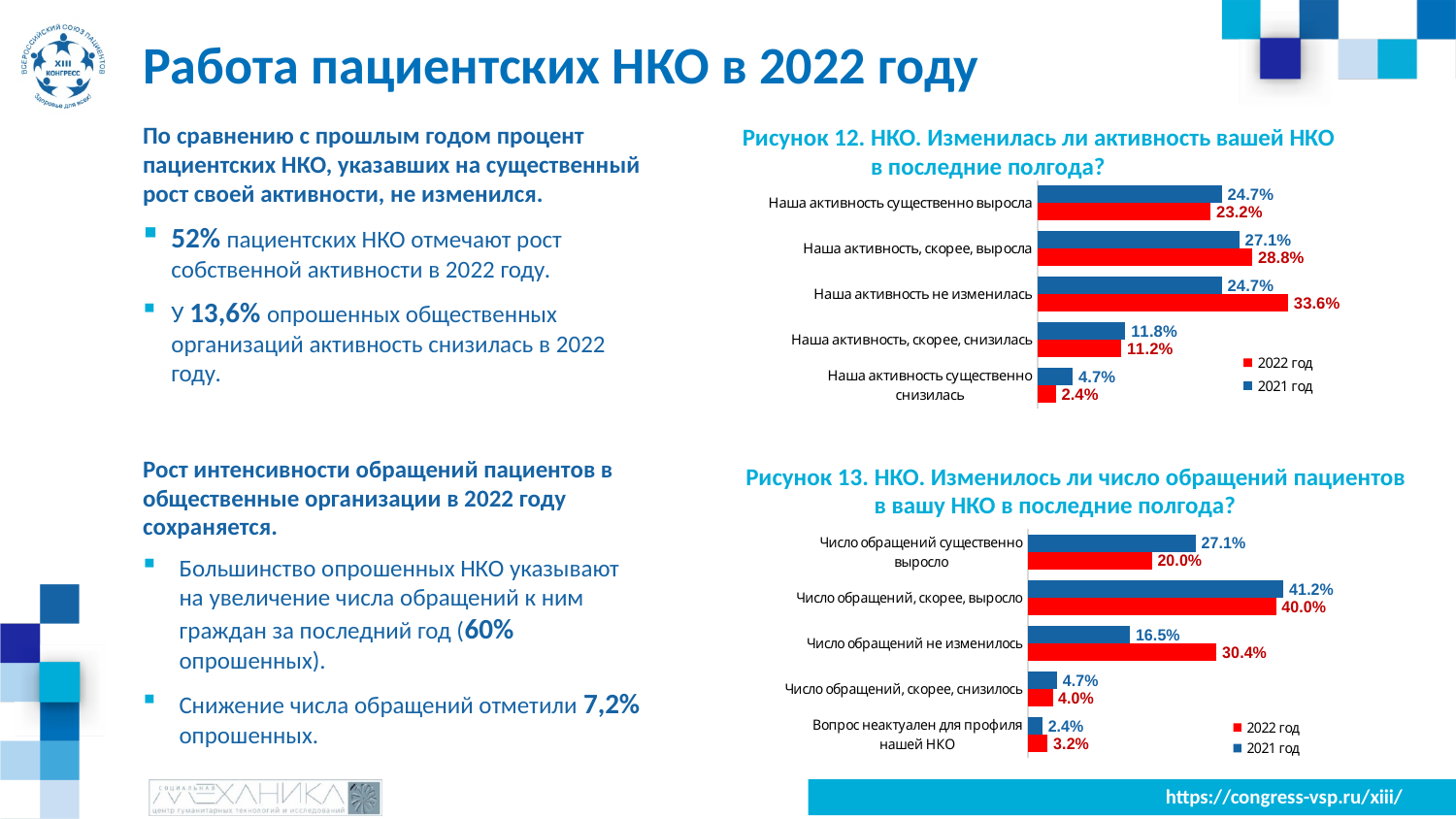
In the chart 'Рисунок 13', which category has the lowest value in the 2021 год series? Вопрос неактуален для профиля нашей НКО In the chart 'Рисунок 12', which is larger for 'Наша активность существенно выросла': the 2021 год value or the 2022 год value? 2021 год In the chart 'Рисунок 13', what is the value for 'Вопрос неактуален для профиля нашей НКО' in the 2022 год series? 3.2% In the chart 'Рисунок 12', which category has the highest value in the 2022 год series? Наша активность не изменилась What type of chart is 'Рисунок 13'? Bar chart In the chart 'Рисунок 13', what is the difference between the 2022 год and 2021 год values for 'Число обращений не изменилось'? 13.9% In the chart 'Рисунок 12', what is the value for 'Наша активность существенно снизилась' in the 2021 год series? 4.7% In the chart 'Рисунок 12. НКО. Изменилась ли активность вашей НКО в последние полгода?', what is the value for 'Наша активность не изменилась' in the 2022 год series? 33.6% In the chart 'Рисунок 13. НКО. Изменилось ли число обращений пациентов в вашу НКО в последние полгода?', what is the value for 'Число обращений, скорее, выросло' in the 2021 год series? 41.2% In the chart 'Рисунок 12', how many series does the legend list? 2 In the chart 'Рисунок 13', how many categories are shown? 5 In the chart 'Рисунок 12', what is the difference between the 2022 год and 2021 год values for 'Наша активность не изменилась'? 8.9%